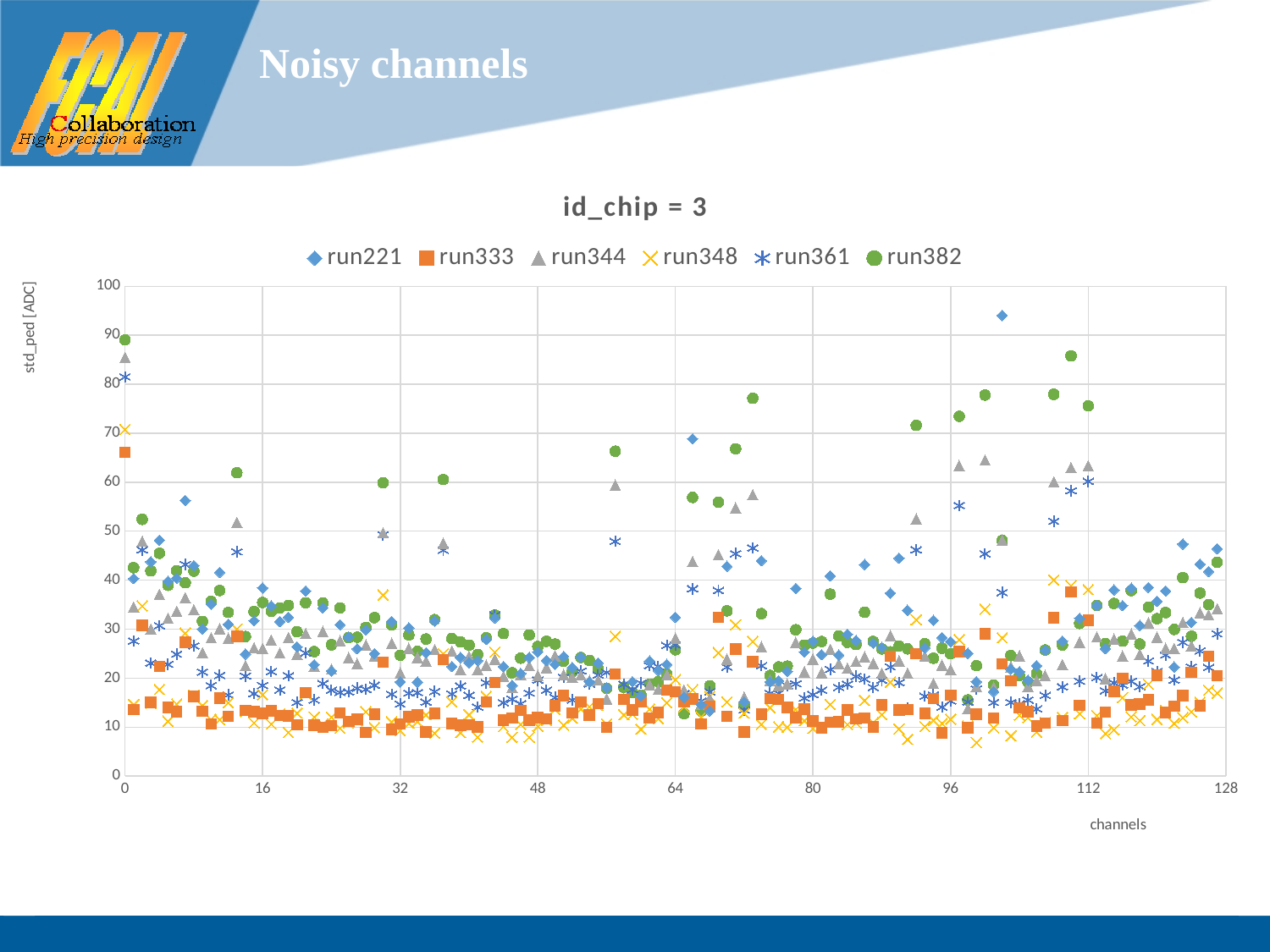
Which series contains the single highest point on the chart? run221 What kind of chart is shown on the slide? scatter chart What is the title of the chart? id_chip = 3 How many series does the legend list? 6 Is the highest value plotted for run221 greater or less than 90? greater Is the value for run382 at channel 0 greater or less than 80? greater Is the value for run361 at channel 0 greater or less than 70? greater What is the label of the y axis? std_ped [ADC] At channel 0, which is larger: the value for run382 or the value for run333? run382